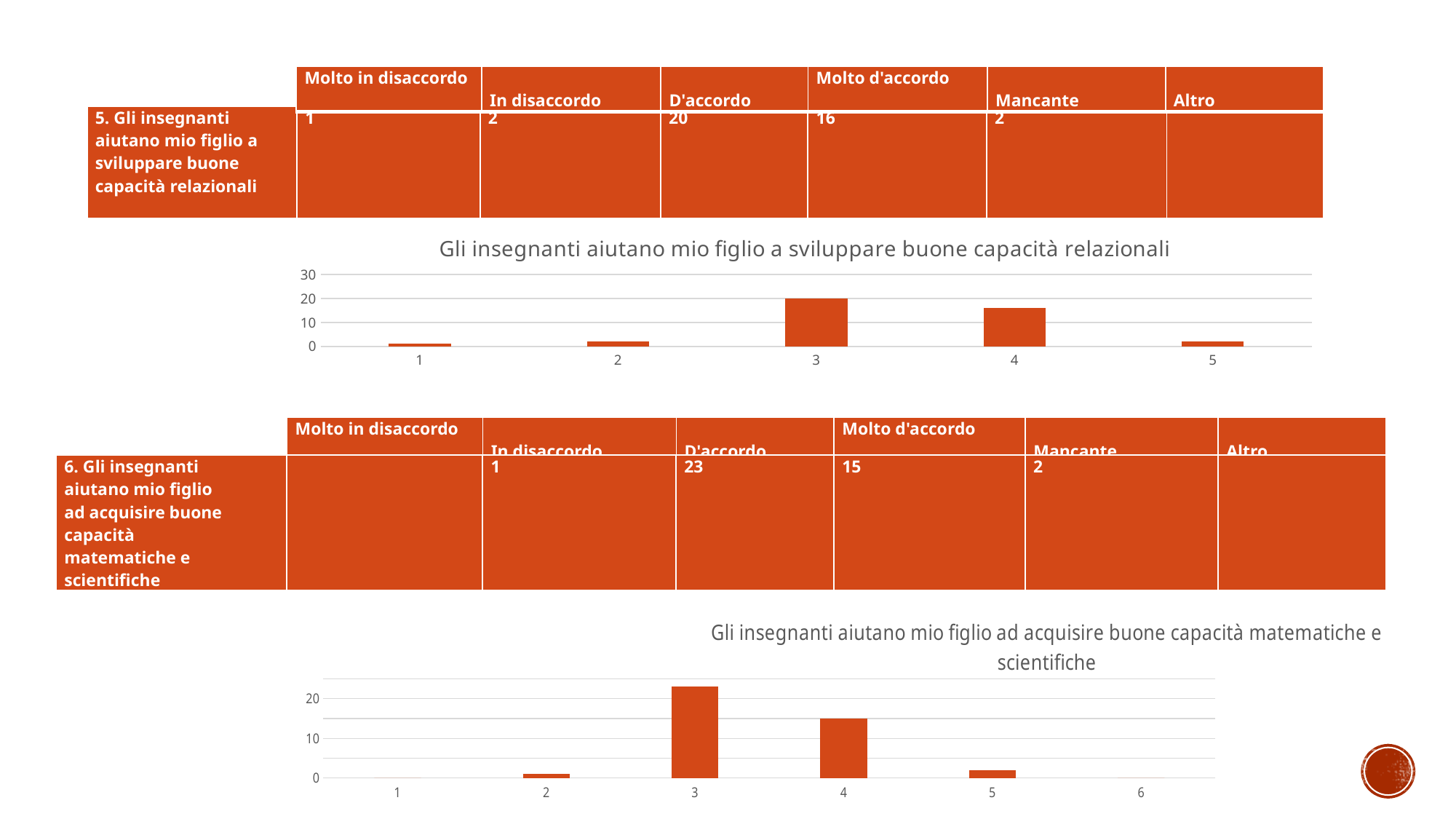
In the top chart 'Gli insegnanti aiutano mio figlio a sviluppare buone capacità relazionali', what is the difference between the values for category 3 and category 4? 4 In the bottom chart 'Gli insegnanti aiutano mio figlio ad acquisire buone capacità matematiche e scientifiche', how many categories are shown on the x axis? 6 In the bottom chart 'Gli insegnanti aiutano mio figlio ad acquisire buone capacità matematiche e scientifiche', is the value for category 3 greater or less than 20? greater In the top chart 'Gli insegnanti aiutano mio figlio a sviluppare buone capacità relazionali', is the value for category 4 greater or less than 10? greater In the bottom chart 'Gli insegnanti aiutano mio figlio ad acquisire buone capacità matematiche e scientifiche', which is larger, the value for category 4 or the value for category 5? category 4 In the top chart 'Gli insegnanti aiutano mio figlio a sviluppare buone capacità relazionali', what is the value for category 3 (D'accordo)? 20 In the top chart 'Gli insegnanti aiutano mio figlio a sviluppare buone capacità relazionali', which category has the highest bar? 3 In the top chart 'Gli insegnanti aiutano mio figlio a sviluppare buone capacità relazionali', what is the value for category 4 (Molto d'accordo)? 16 In the bottom chart 'Gli insegnanti aiutano mio figlio ad acquisire buone capacità matematiche e scientifiche', what is the value for category 3 (D'accordo)? 23 In the bottom chart 'Gli insegnanti aiutano mio figlio ad acquisire buone capacità matematiche e scientifiche', which category has the highest bar? 3 In the top chart 'Gli insegnanti aiutano mio figlio a sviluppare buone capacità relazionali', how many categories are shown on the x axis? 5 In the top chart 'Gli insegnanti aiutano mio figlio a sviluppare buone capacità relazionali', what kind of chart is shown? bar chart